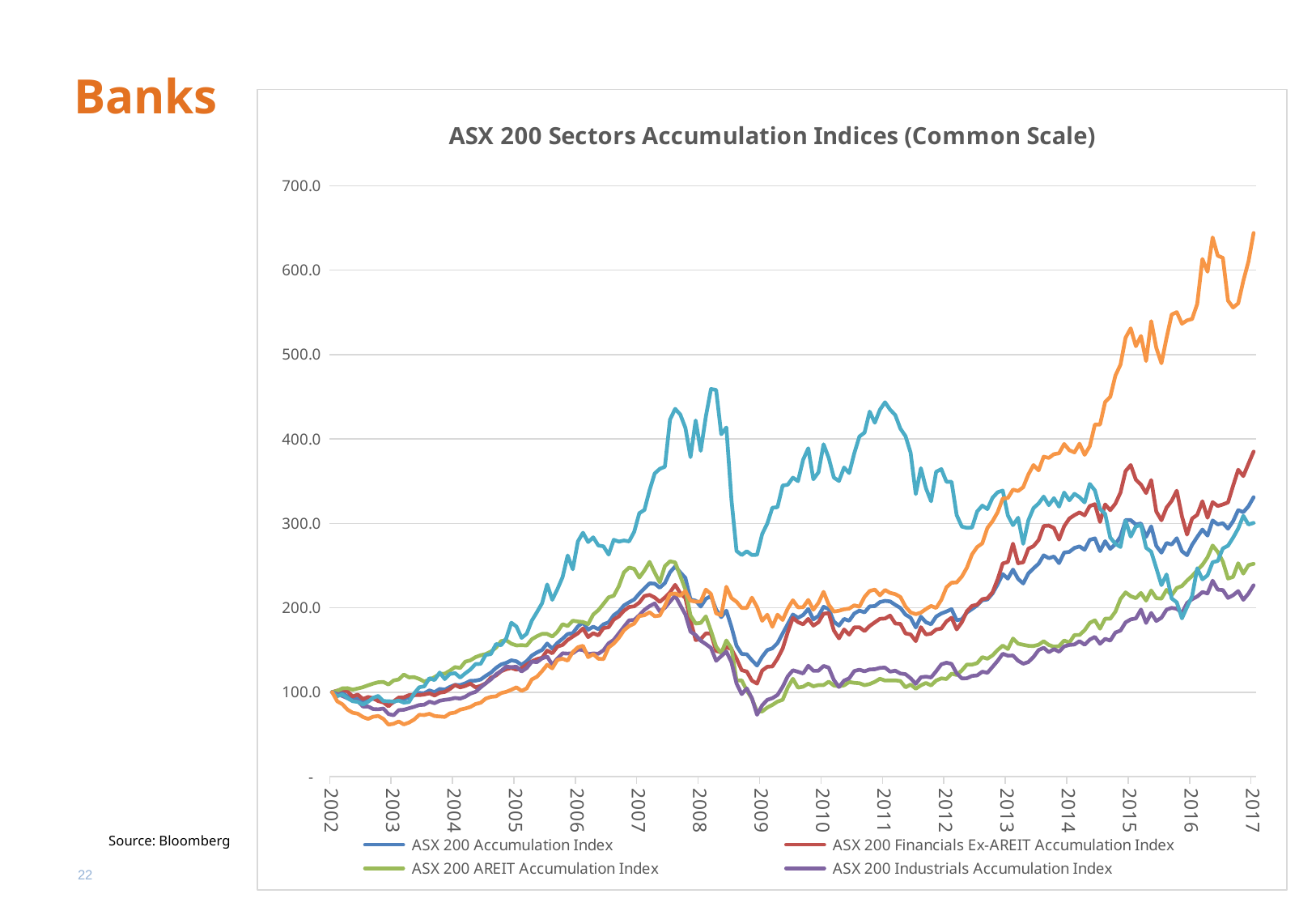
What is the source cited for the chart? Bloomberg How many series does the chart's legend list? 4 Is the value of the ASX 200 Financials Ex-AREIT Accumulation Index at 2017 greater or less than 400? less Is the value of the ASX 200 Financials Ex-AREIT Accumulation Index at 2017 greater or less than 300? greater Of the four series listed in the legend, which has the lowest value at 2017? ASX 200 Industrials Accumulation Index What is the title of the chart? ASX 200 Sectors Accumulation Indices (Common Scale) Is the value of the ASX 200 AREIT Accumulation Index at 2017 greater or less than 300? less At 2017, which is higher: the ASX 200 Financials Ex-AREIT Accumulation Index or the ASX 200 Industrials Accumulation Index? ASX 200 Financials Ex-AREIT Accumulation Index At what value do the indices start in 2002? 100.0 Does the ASX 200 Financials Ex-AREIT Accumulation Index rise or fall between 2012 and 2017? rise What kind of chart is shown on the slide? line chart